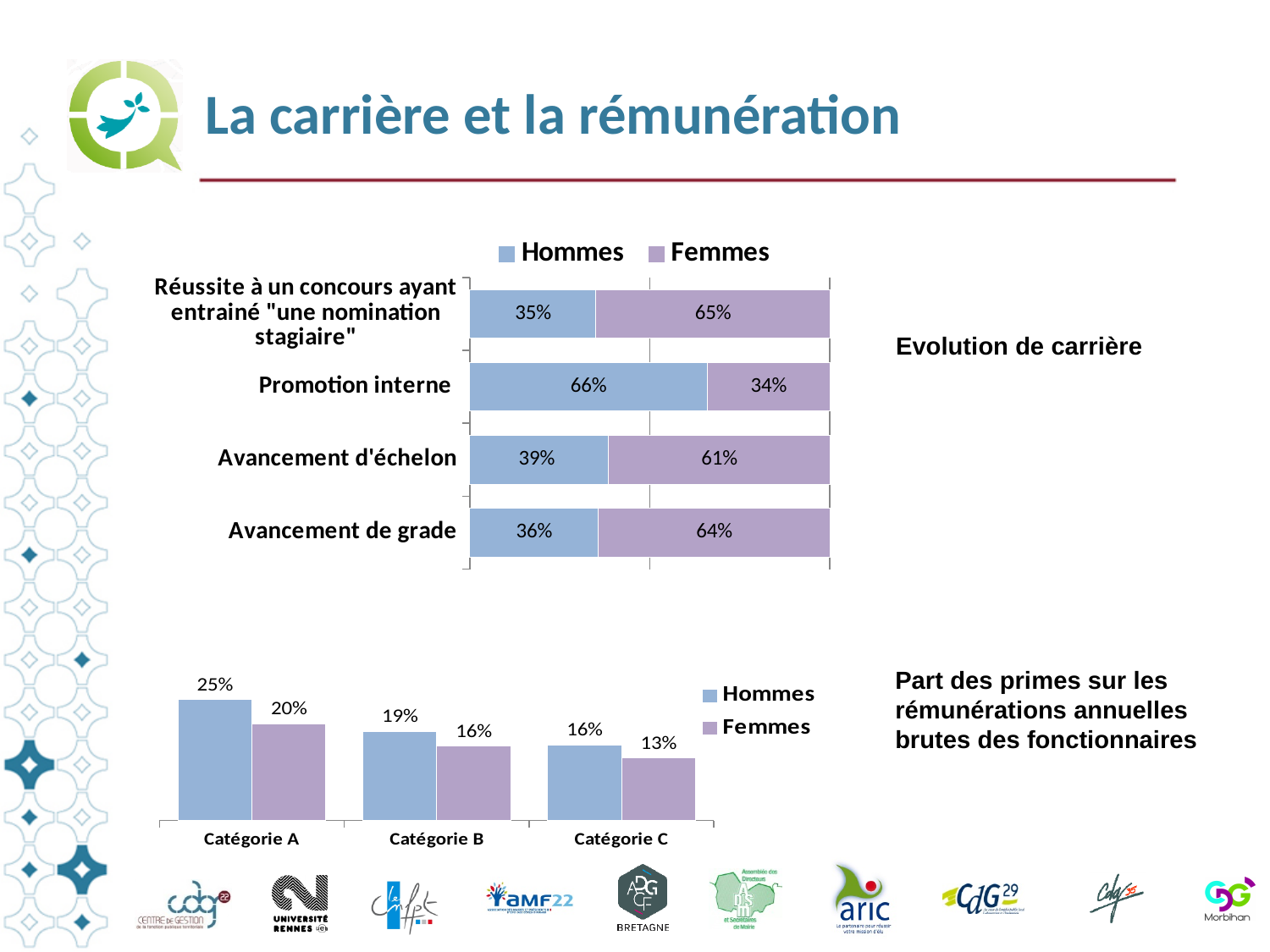
In the top chart (Evolution de carrière), what is the value for Hommes for Promotion interne? 66% In the top chart (Evolution de carrière), how many categories are shown? 4 In the top chart (Evolution de carrière), what is the total of the stacked bar for Promotion interne? 100% In the bottom chart (Part des primes sur les rémunérations annuelles brutes des fonctionnaires), do the Hommes values rise or fall from Catégorie A to Catégorie C? fall In the top chart (Evolution de carrière), what is the difference between the Femmes and Hommes values for Avancement de grade? 28% In the top chart (Evolution de carrière), what is the value for Femmes for Avancement de grade? 64% In the top chart (Evolution de carrière), which category has the highest Hommes value? Promotion interne How many series does the legend of the bottom chart list? 2 In the bottom chart (Part des primes sur les rémunérations annuelles brutes des fonctionnaires), what is the difference between Hommes and Femmes in Catégorie A? 5% In the top chart (Evolution de carrière), what is the value for Femmes for Avancement d'échelon? 61% In the bottom chart (Part des primes sur les rémunérations annuelles brutes des fonctionnaires), what is the value for Femmes in Catégorie C? 13% In the bottom chart (Part des primes sur les rémunérations annuelles brutes des fonctionnaires), which category has the highest Hommes value? Catégorie A